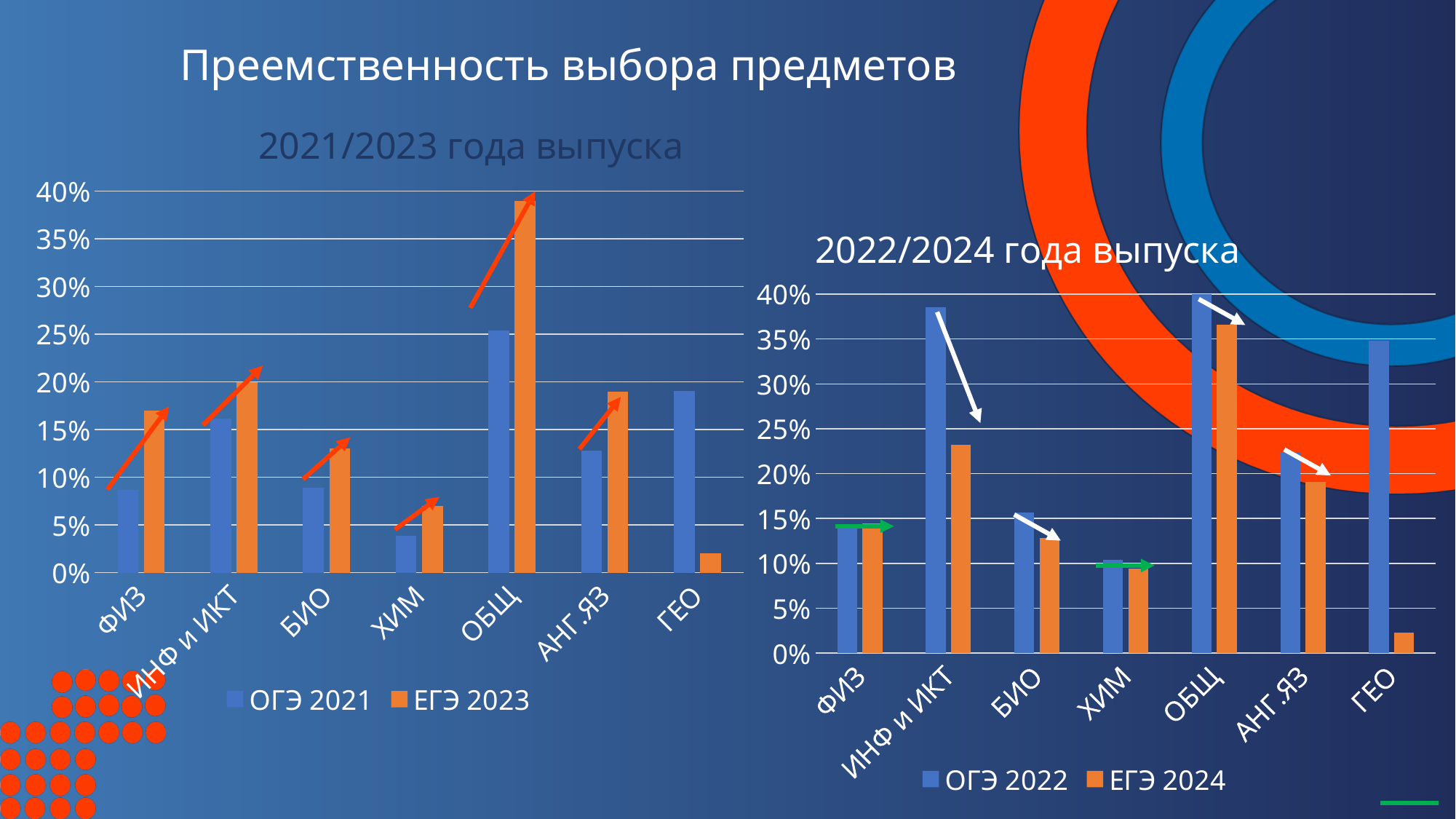
In the chart titled "2022/2024 года выпуска", is the ЕГЭ 2024 value for ГЕО greater or less than 5%? less In the chart titled "2022/2024 года выпуска", which category has the lowest value for ОГЭ 2022? ХИМ How many series does the legend of the chart titled "2022/2024 года выпуска" list? 2 In the chart titled "2021/2023 года выпуска", is the ОГЭ 2021 value for ХИМ greater or less than 5%? less In the chart titled "2022/2024 года выпуска", for ИНФ и ИКТ, which series has the larger value: ОГЭ 2022 or ЕГЭ 2024? ОГЭ 2022 In the chart titled "2021/2023 года выпуска", is the ЕГЭ 2023 value for ОБЩ greater or less than 35%? greater In the chart titled "2021/2023 года выпуска", which category has the lowest value for ЕГЭ 2023? ГЕО How many categories are shown on the x axis of the chart titled "2021/2023 года выпуска"? 7 In the chart titled "2021/2023 года выпуска", for ГЕО, which series has the larger value: ОГЭ 2021 or ЕГЭ 2023? ОГЭ 2021 What kind of chart is the chart titled "2022/2024 года выпуска"? bar chart In the chart titled "2021/2023 года выпуска", which category has the highest value for ЕГЭ 2023? ОБЩ